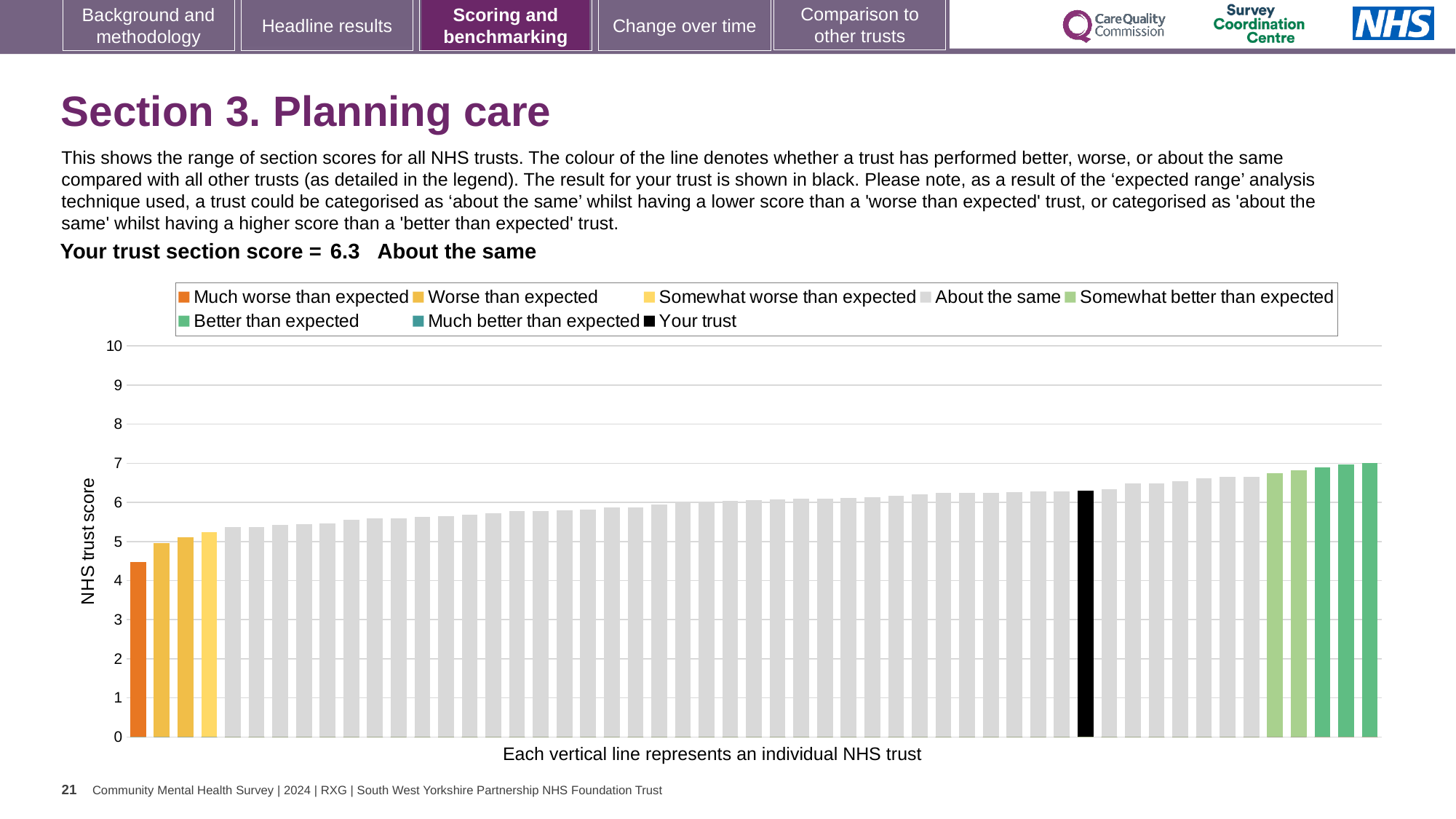
Do the bar values rise or fall from left to right along the x axis? Rise What is the label on the vertical axis of the chart? NHS trust score Is the value for the lowest (orange) bar greater or less than 5? less How many bars are coloured orange for 'Much worse than expected'? 1 How is your trust's score categorised compared with other trusts? About the same What is the section score for your trust shown on the slide? 6.3 How many bars are coloured green for 'Better than expected'? 3 How many entries does the chart legend list? 8 Is the value for your trust's bar greater or less than 6? greater Which is larger: your trust's bar or the orange 'Much worse than expected' bar? Your trust's bar Is the value for the tallest bar on the right greater or less than 6? greater What kind of chart is shown on the slide? Bar chart